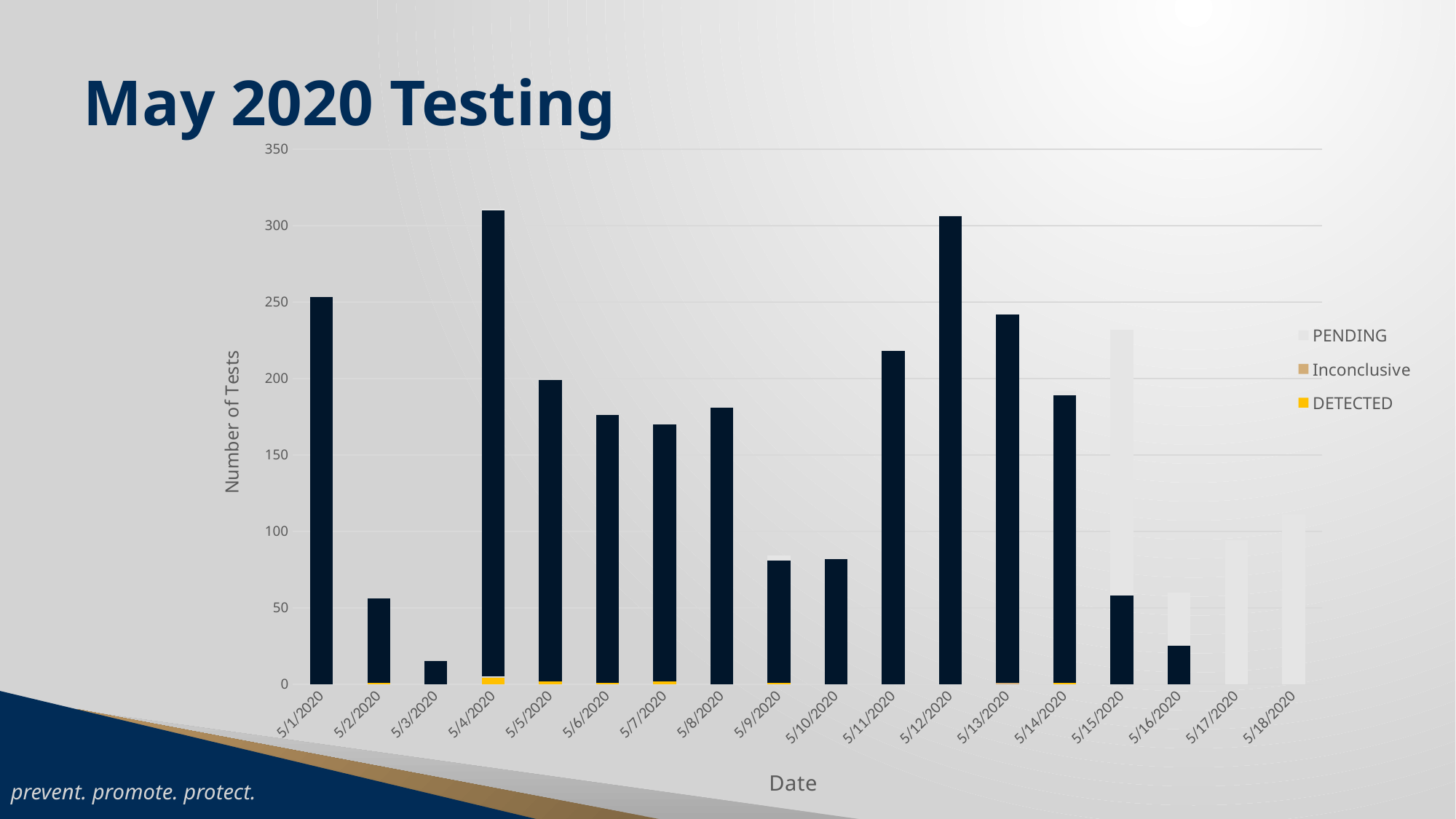
How many dates are shown along the x axis of the chart? 18 What is the title of the chart on the slide? May 2020 Testing How many series does the chart's legend list? 3 Is the value for 5/3/2020 greater or less than 50? less Is the value for 5/11/2020 greater or less than 200? greater What is the label on the vertical axis of the chart? Number of Tests From 5/4/2020 to 5/7/2020, do the bar values rise or fall? fall Is the value for 5/10/2020 greater or less than 100? less What kind of chart is shown on the slide? bar chart Which date has the taller bar, 5/1/2020 or 5/5/2020? 5/1/2020